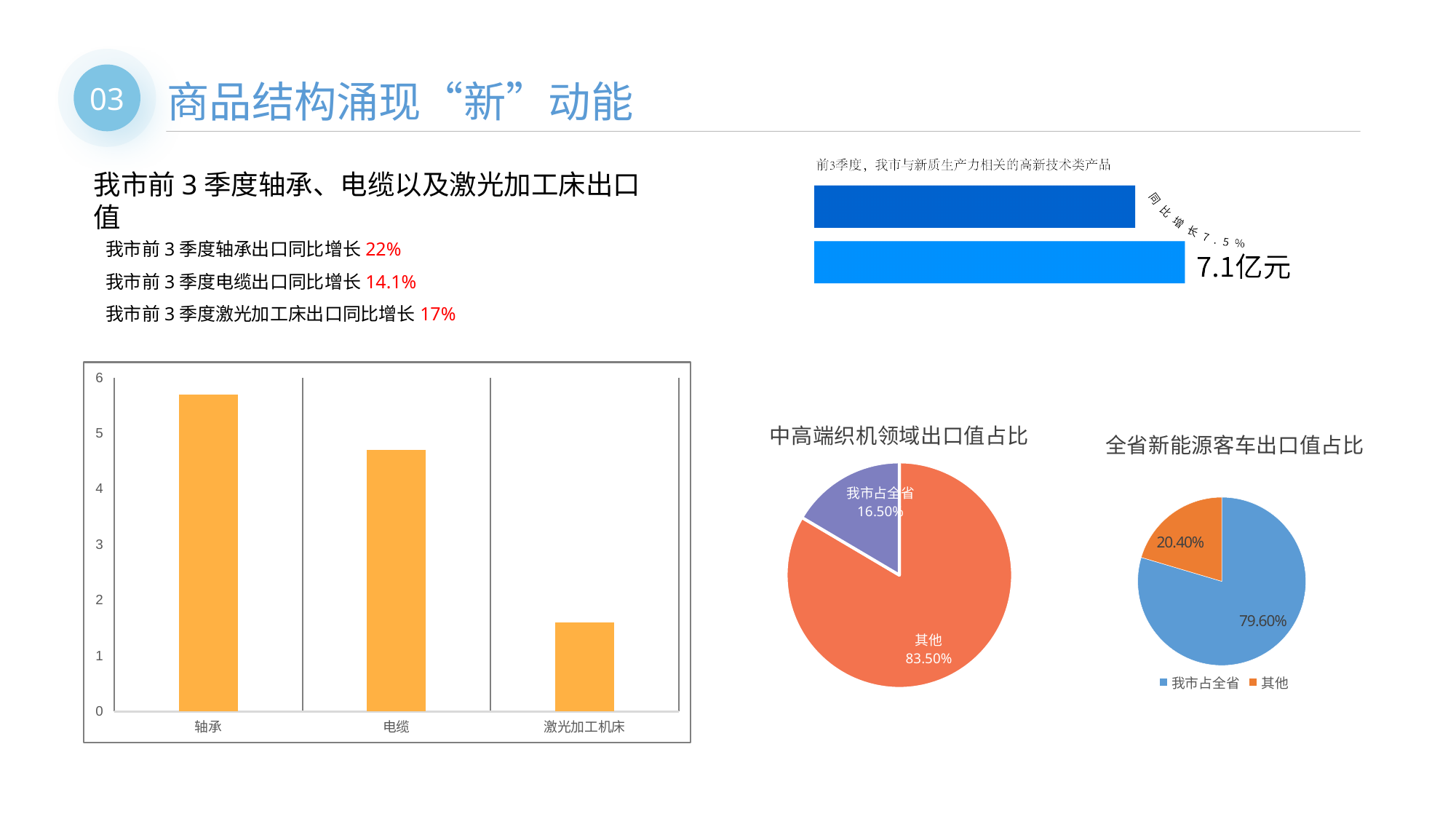
In the pie chart titled 中高端织机领域出口值占比, what share does 其他 have? 83.50% How many entries does the legend of the pie chart titled 全省新能源客车出口值占比 list? 2 In the bar chart at the bottom left, do the values rise or fall from left to right along the x axis? fall In the pie chart titled 中高端织机领域出口值占比, what share does 我市占全省 have? 16.50% In the bar chart at the bottom left, which category has the lowest bar? 激光加工机床 What kind of chart is the chart at the bottom left of the slide? bar chart In the bar chart at the bottom left, is the value for 轴承 greater or less than 5? greater How many categories does the bar chart at the bottom left show? 3 In the bar chart at the bottom left, which category has the highest bar? 轴承 In the pie chart titled 全省新能源客车出口值占比, what share does the orange slice (其他) have? 20.40% In the bar chart at the bottom left, which is larger, the value for 电缆 or the value for 激光加工机床? 电缆 In the bar chart at the bottom left, is the value for 激光加工机床 greater or less than 2? less